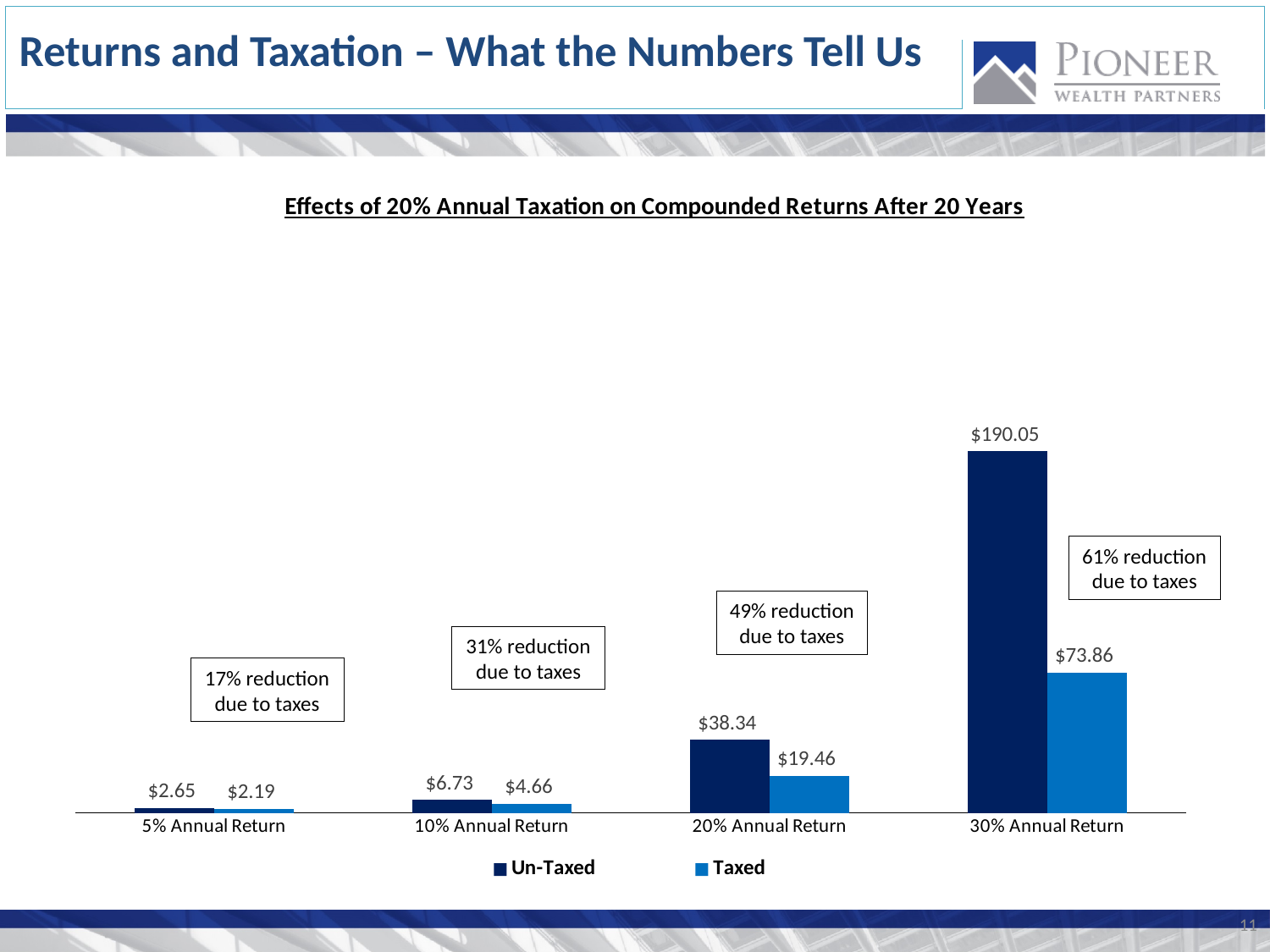
Which category has the highest Un-Taxed value? 30% Annual Return What kind of chart is shown on the slide? Bar chart Which category has the lowest Taxed value? 5% Annual Return Which is larger: the Taxed value for 30% Annual Return or the Un-Taxed value for 20% Annual Return? Taxed value for 30% Annual Return What is the difference between the Un-Taxed and Taxed values for 30% Annual Return? $116.19 What is the Taxed value for 20% Annual Return? $19.46 What is the difference between the Un-Taxed and Taxed values for 20% Annual Return? $18.88 How many series does the legend list? 2 How many categories are shown on the x axis? 4 What is the Un-Taxed value for 5% Annual Return? $2.65 What is the Taxed value for 10% Annual Return? $4.66 What is the Un-Taxed value for 30% Annual Return? $190.05